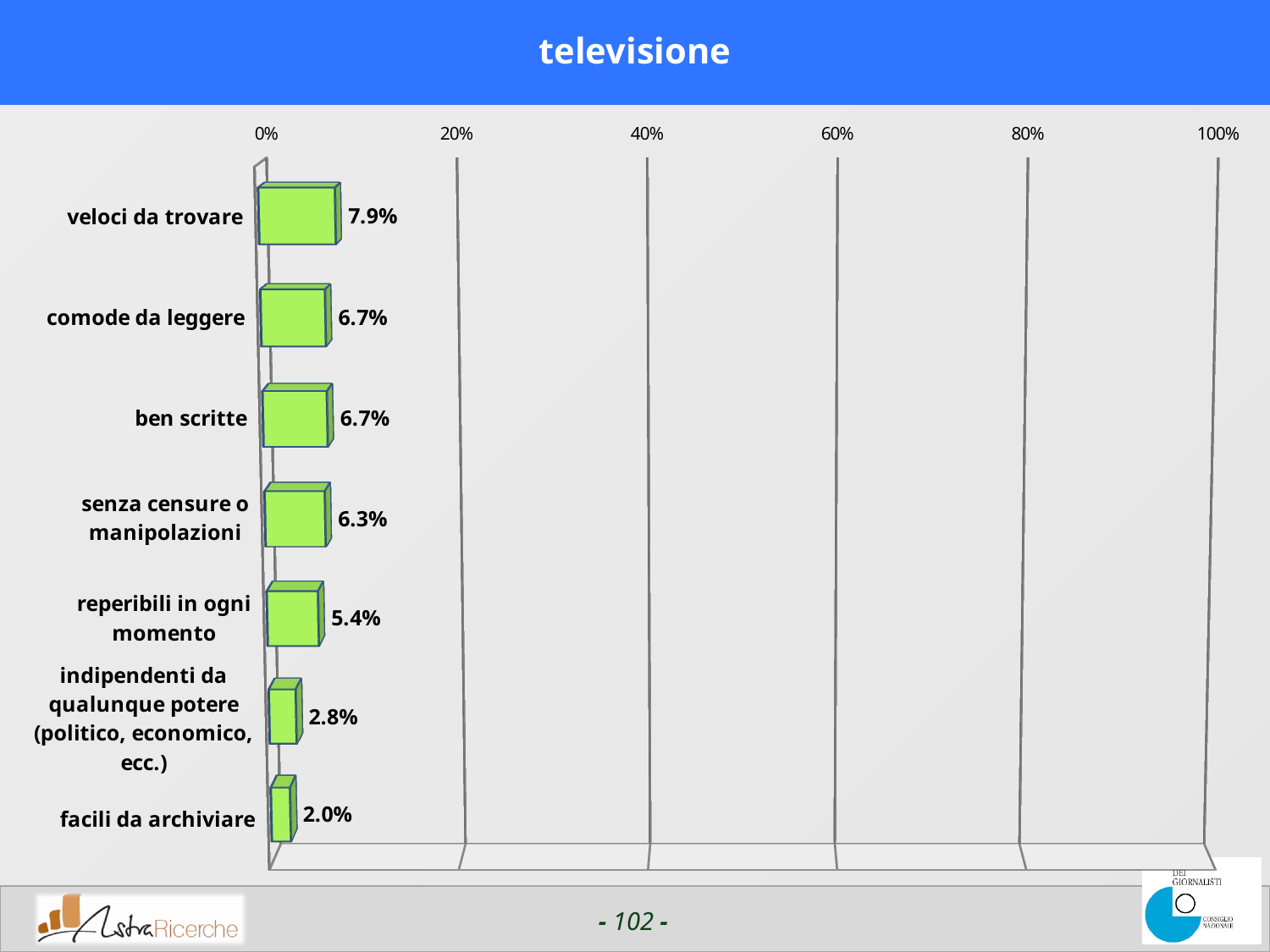
What kind of chart is shown on the slide? bar chart Which category has the lowest value? facili da archiviare Which is larger, the value for "ben scritte" or the value for "senza censure o manipolazioni"? ben scritte Which category has the highest value? veloci da trovare What is the value for "indipendenti da qualunque potere (politico, economico, ecc.)"? 2.8% Is the value for "veloci da trovare" greater or less than 20%? less What is the difference between the values for "veloci da trovare" and "facili da archiviare"? 5.9% What is the value for "facili da archiviare"? 2.0% What is the value for "veloci da trovare"? 7.9% What is the value for "reperibili in ogni momento"? 5.4% How many categories are shown in the chart? 7 What is the difference between the values for "senza censure o manipolazioni" and "reperibili in ogni momento"? 0.9%